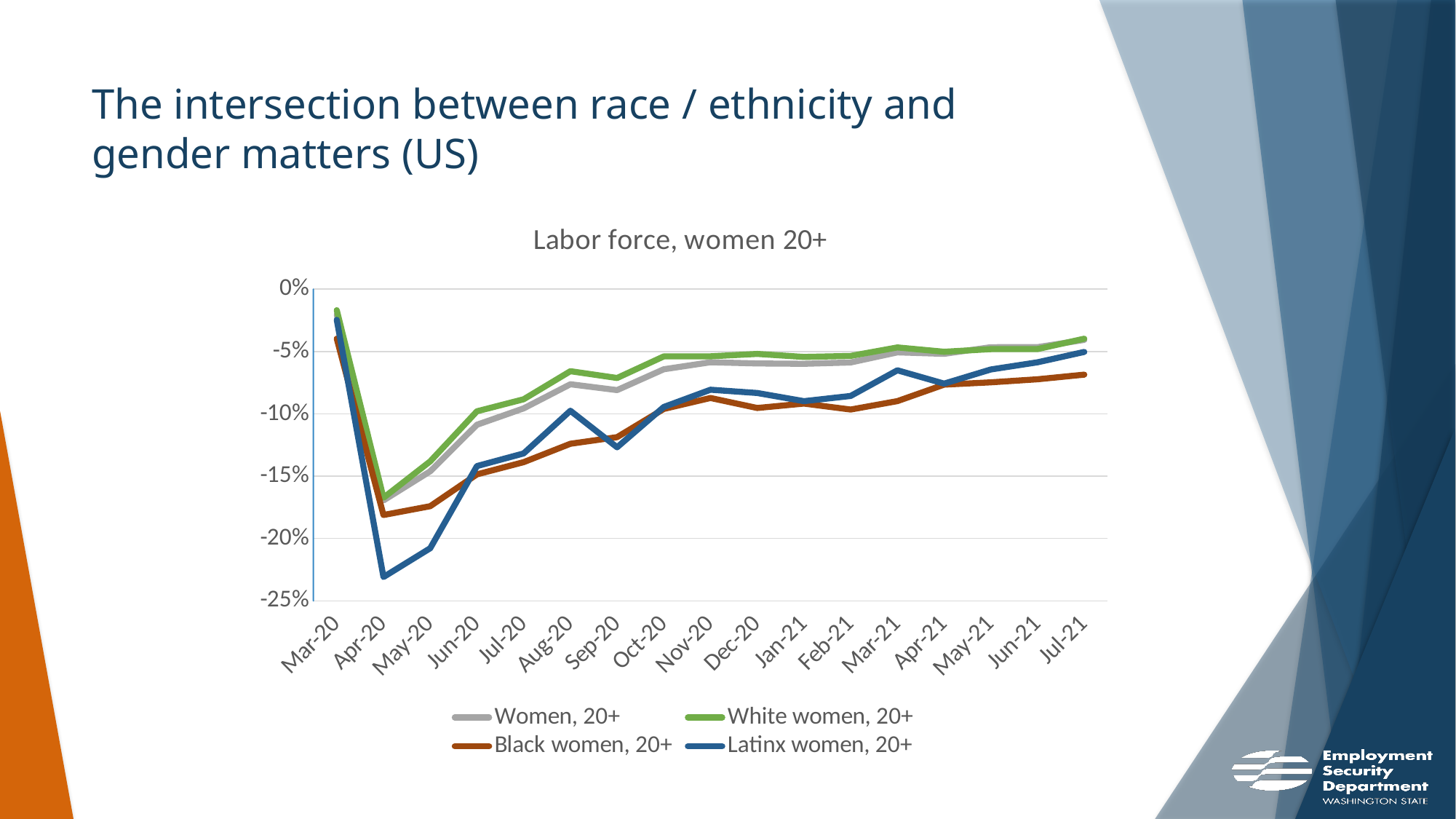
What is the title of the chart? Labor force, women 20+ Which series has the highest value in Jul-21? White women, 20+ Is the value for White women, 20+ in Jul-21 greater or less than -5%? greater Which series has the lowest value in Apr-20? Latinx women, 20+ How many series does the legend list? 4 Which series is drawn in green? White women, 20+ From Apr-20 to Jul-21, do the values for Women, 20+ generally rise or fall? rise In Jul-21, which is higher: White women, 20+ or Black women, 20+? White women, 20+ What kind of chart is shown on the slide? line chart Is the value for Latinx women, 20+ in Apr-20 greater or less than -20%? less How many months are shown along the x axis? 17 Is the value for Black women, 20+ in Apr-20 greater or less than -15%? less